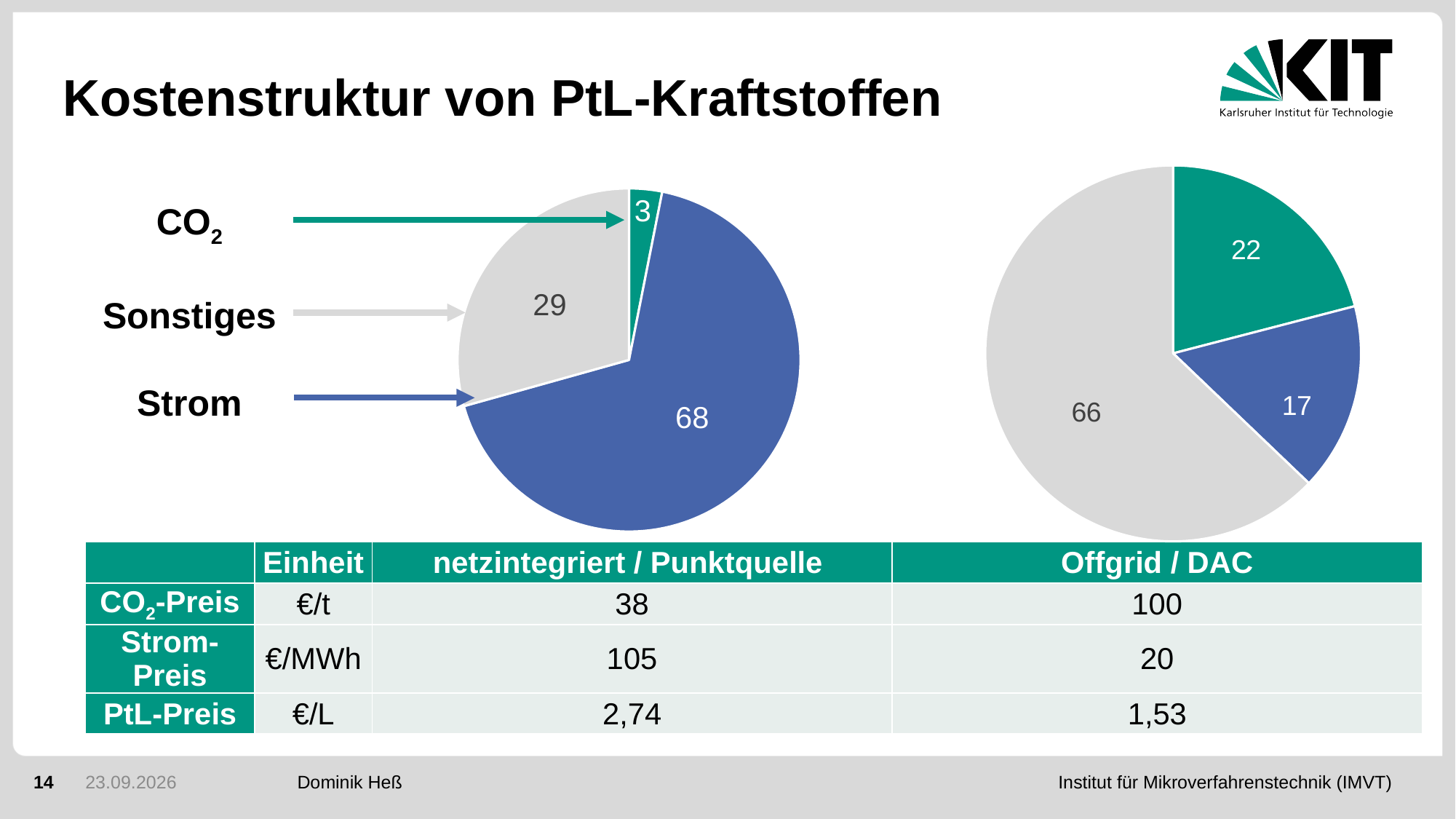
In the right pie chart, what is the value for Strom? 17 What type of chart is shown on the left of the slide? Pie chart In the right pie chart, which is larger, the CO2 slice or the Strom slice? CO2 In the left pie chart, what is the value for Sonstiges? 29 In the left pie chart, which category has the smallest slice? CO2 In the left pie chart, what is the value for CO2? 3 In the left pie chart, what is the value for Strom? 68 In the right pie chart, which category has the largest slice? Sonstiges In the right pie chart, what is the value for CO2? 22 In the left pie chart, what is the difference between the Strom value and the Sonstiges value? 39 Which colour represents Strom in the pie charts? Blue How many slices does the left pie chart have? 3